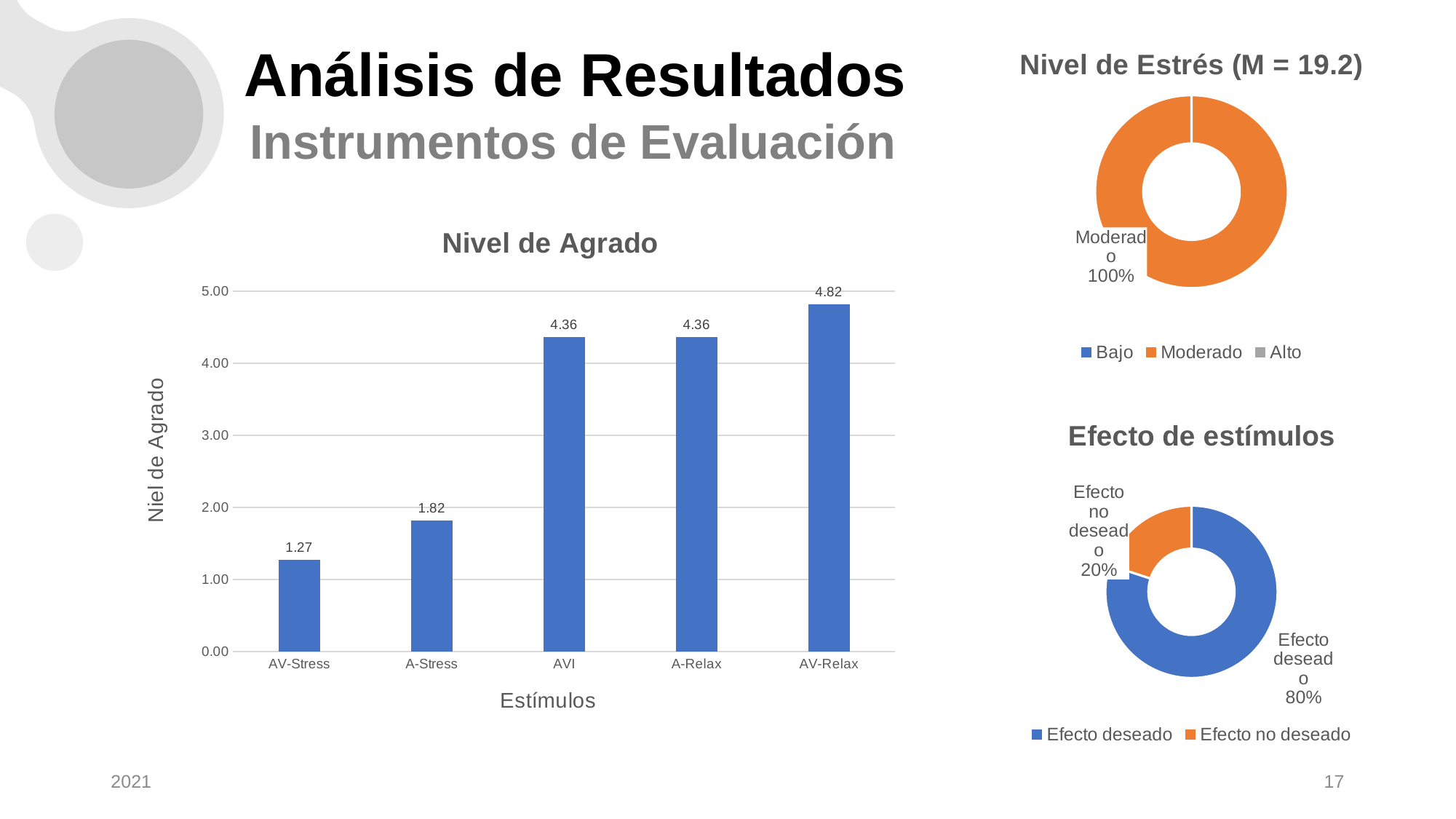
In the 'Nivel de Agrado' chart, which is larger, the value for A-Stress or the value for AVI? AVI In the 'Nivel de Agrado' chart, which stimulus has the highest value? AV-Relax In the 'Efecto de estímulos' chart, what share does 'Efecto no deseado' have? 20% In the 'Nivel de Estrés (M = 19.2)' chart, what share does Moderado have? 100% In the 'Nivel de Agrado' chart, how many stimuli are shown on the x axis? 5 In the 'Nivel de Agrado' chart, what is the value for A-Stress? 1.82 In the 'Nivel de Agrado' chart, what is the value for AV-Relax? 4.82 In the 'Nivel de Agrado' chart, which stimulus has the lowest value? AV-Stress What kind of chart is 'Nivel de Agrado'? Bar chart In the 'Nivel de Agrado' chart, what is the difference between the values for AV-Relax and AV-Stress? 3.55 In the 'Efecto de estímulos' chart, which slice is larger, 'Efecto deseado' or 'Efecto no deseado'? Efecto deseado How many entries does the legend of the 'Nivel de Estrés (M = 19.2)' chart list? 3